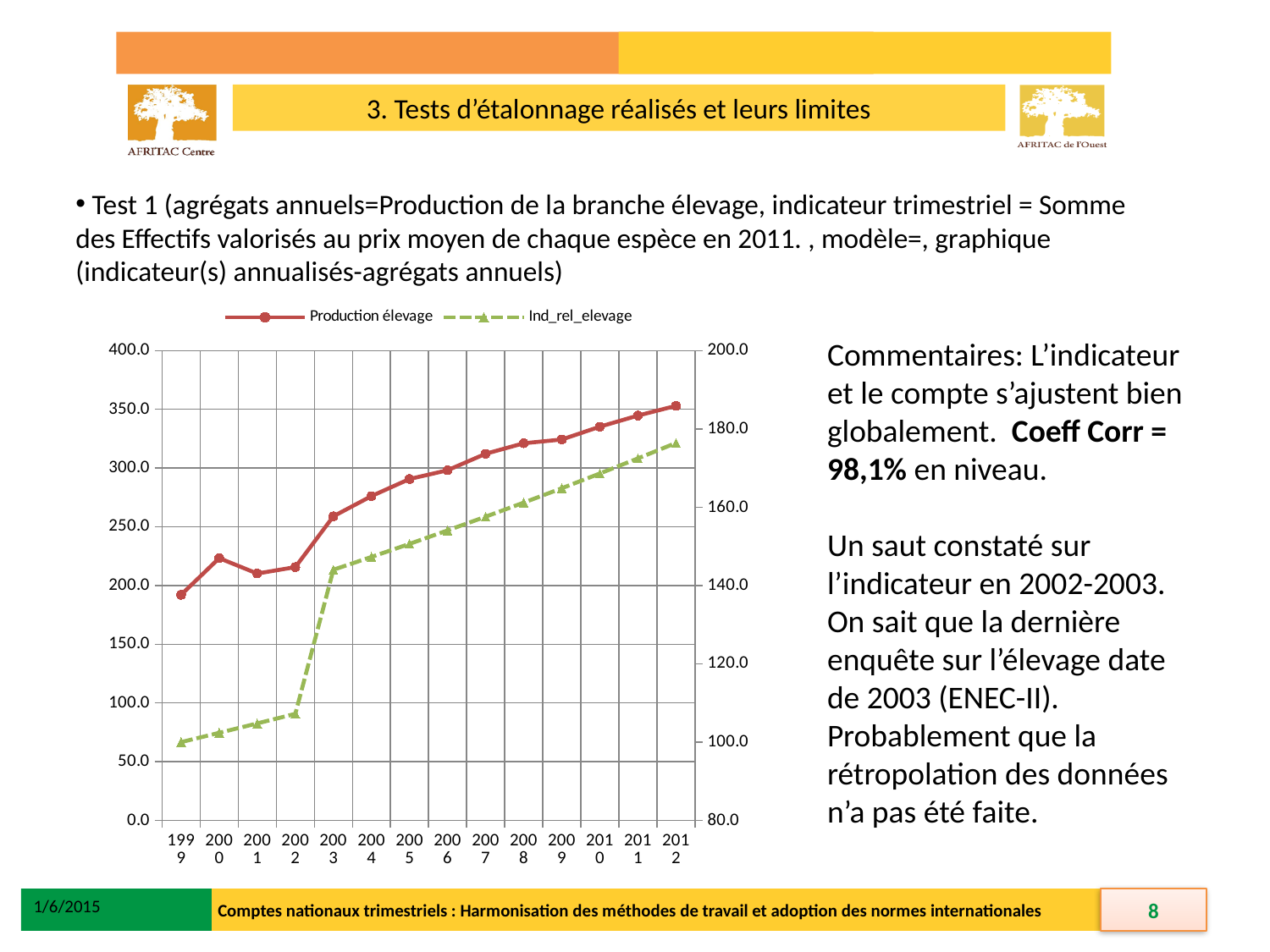
Is the value for Production élevage in 2012 greater or less than 300? greater Which is larger for Production élevage: the value in 2000 or the value in 2001? 2000 Which year has the highest value for Production élevage? 2012 Which year has the lowest value for Ind_rel_elevage? 1999 Which year has the lowest value for Production élevage? 1999 How many series does the chart legend list? 2 How many years are plotted along the x axis of the chart? 14 Is the value for Production élevage in 1999 greater or less than 250? less Is the value for Ind_rel_elevage in 2002 greater or less than 120? less What kind of chart is shown on the slide? line chart Does the Ind_rel_elevage series generally rise or fall from 1999 to 2012? rise